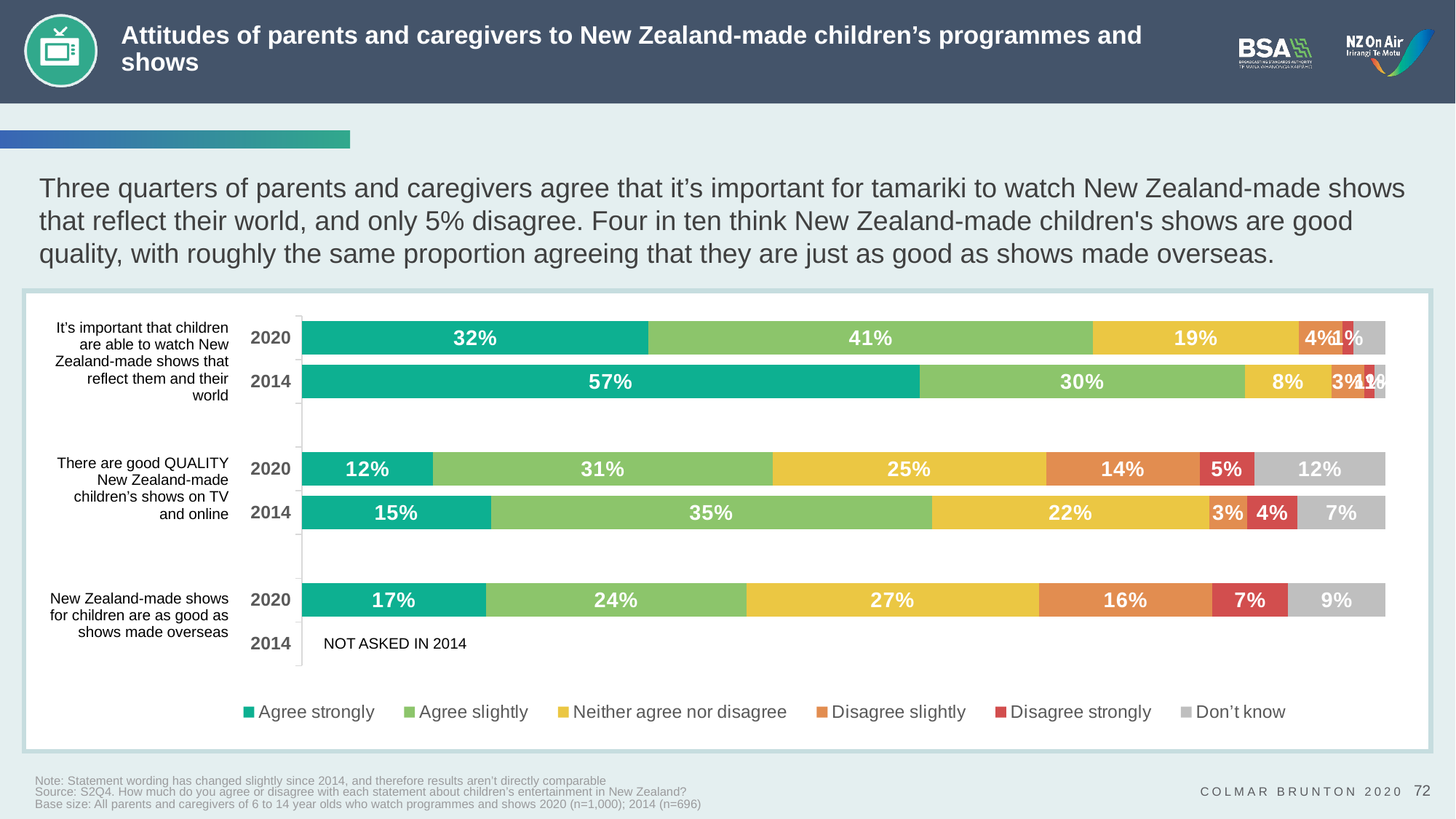
By how many percentage points did 'Agree strongly' for the statement about children watching New Zealand-made shows that reflect their world fall from 2014 to 2020? 25 percentage points What percentage agreed strongly in 2014 that it's important that children are able to watch New Zealand-made shows that reflect them and their world? 57% What percentage neither agreed nor disagreed in 2020 that New Zealand-made shows for children are as good as shows made overseas? 27% What percentage of parents and caregivers agreed strongly in 2020 that there are good QUALITY New Zealand-made children's shows on TV and online? 12% Which statement and year has the highest 'Agree strongly' percentage? It's important that children are able to watch New Zealand-made shows that reflect them and their world, 2014 What kind of chart is shown on the slide? Stacked bar chart How many statements are shown on the chart? 3 What percentage disagreed strongly in 2020 that New Zealand-made shows for children are as good as shows made overseas? 7% What is shown for 2014 for the statement that New Zealand-made shows for children are as good as shows made overseas? NOT ASKED IN 2014 What is the combined 'Agree strongly' and 'Agree slightly' percentage in 2020 for the statement that New Zealand-made shows for children are as good as shows made overseas? 41% How many series does the legend list? 6 For the statement about good QUALITY New Zealand-made children's shows, was the 'Don't know' share larger in 2020 or 2014? 2020